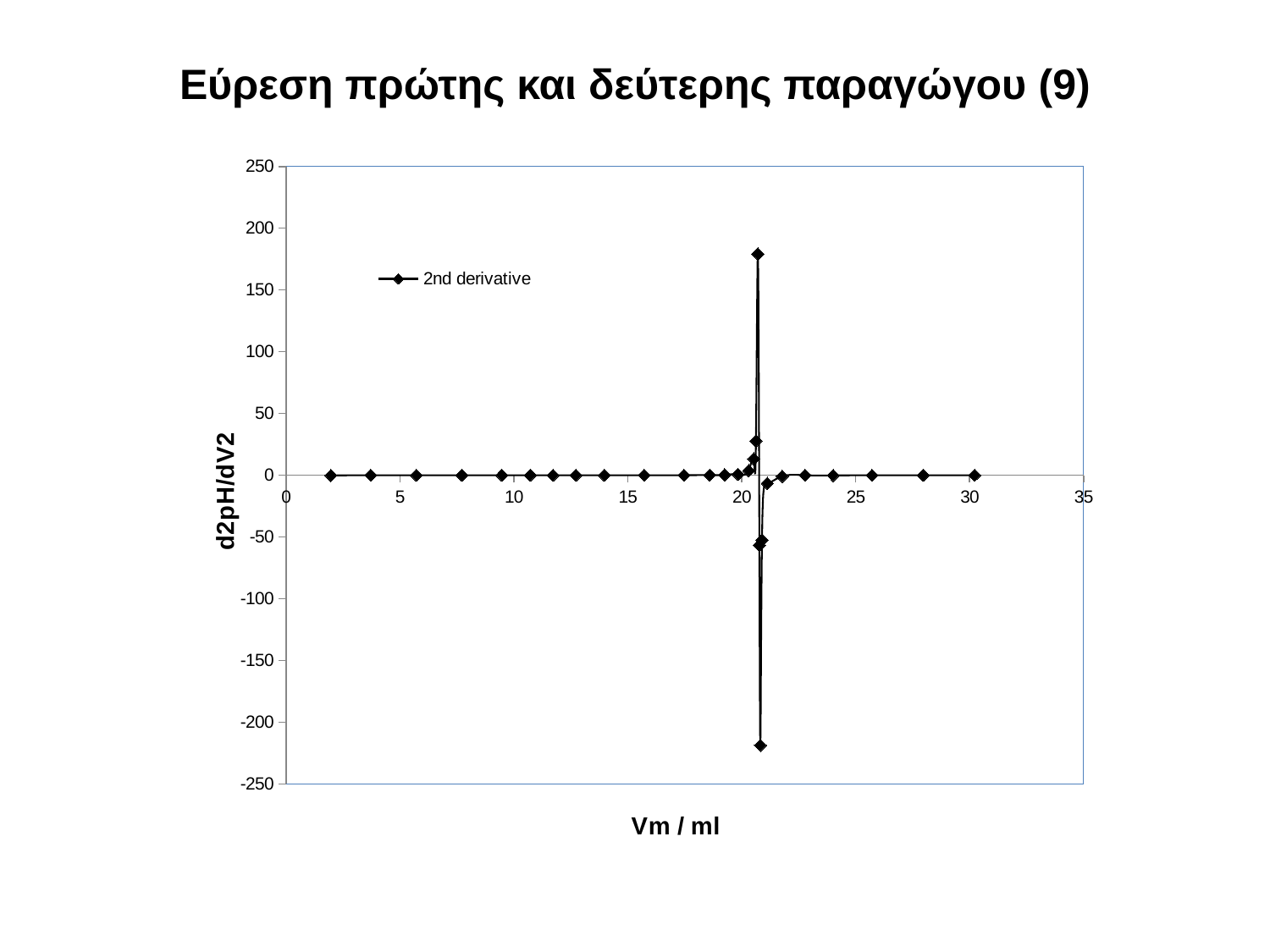
What is the maximum value shown on the y axis? 250 Is the highest value of the 2nd derivative series greater or less than 200? less What is the title of the x axis? Vm / ml Is the lowest value of the 2nd derivative series greater or less than -250? greater Is the value of the 2nd derivative at Vm = 10 ml greater or less than 50? less What is the name of the series shown in the legend? 2nd derivative How many series does the legend list? 1 What kind of chart is shown on the slide? line chart Which is farther from zero: the highest point of the series or the lowest point of the series? the lowest point